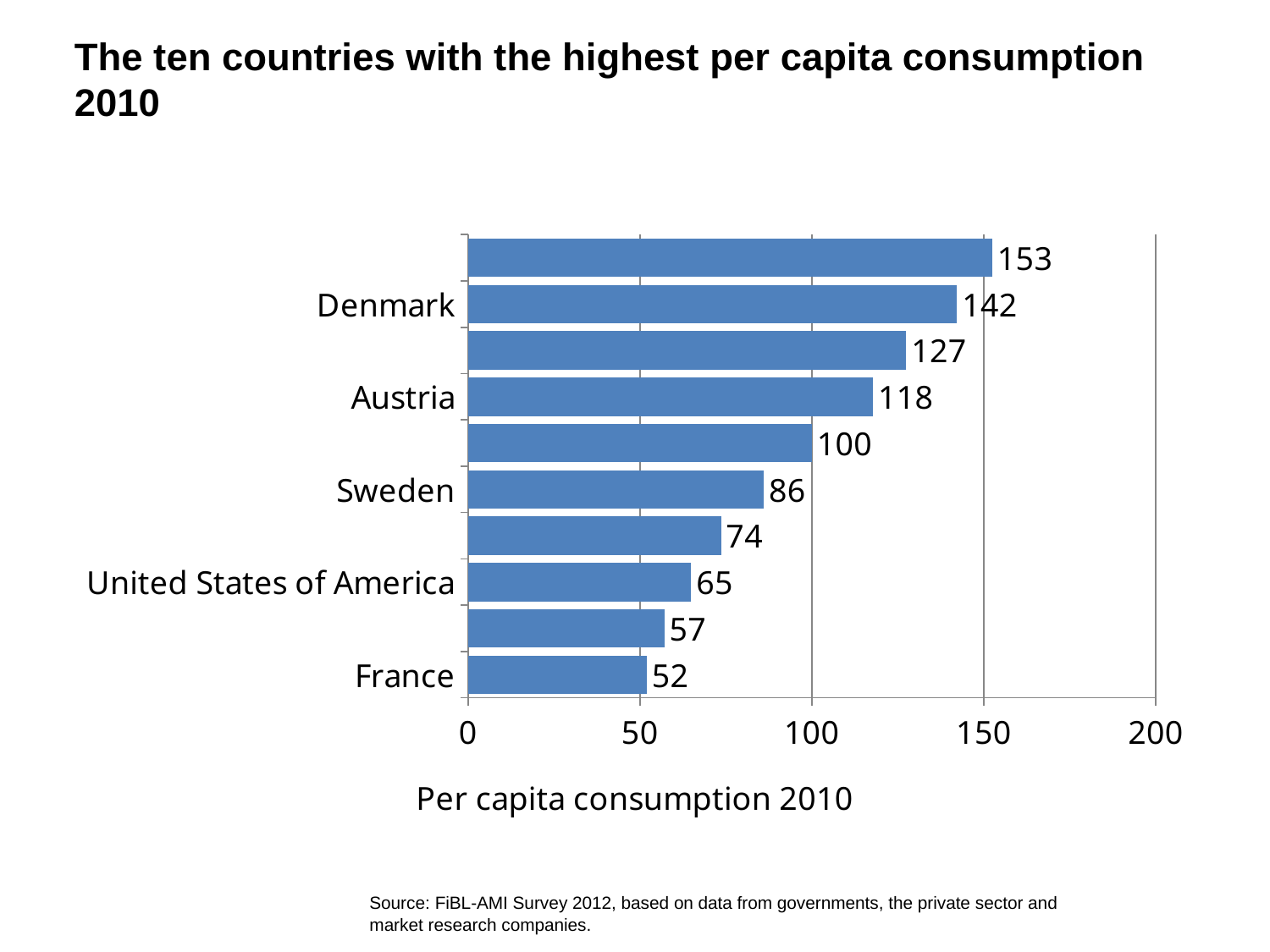
What kind of chart is shown on the slide? Bar chart What is the per capita consumption value for Austria? 118 What is the per capita consumption value for France? 52 How many bars are shown on the chart? 10 What is the difference between the values for Denmark and Austria? 24 What is the largest value shown on the chart? 153 Which labelled country has the lowest per capita consumption? France What is the label of the horizontal axis? Per capita consumption 2010 Which has a higher value, Sweden or the United States of America? Sweden What is the per capita consumption value for Denmark? 142 What is the per capita consumption value for Sweden? 86 What is the per capita consumption value for the United States of America? 65